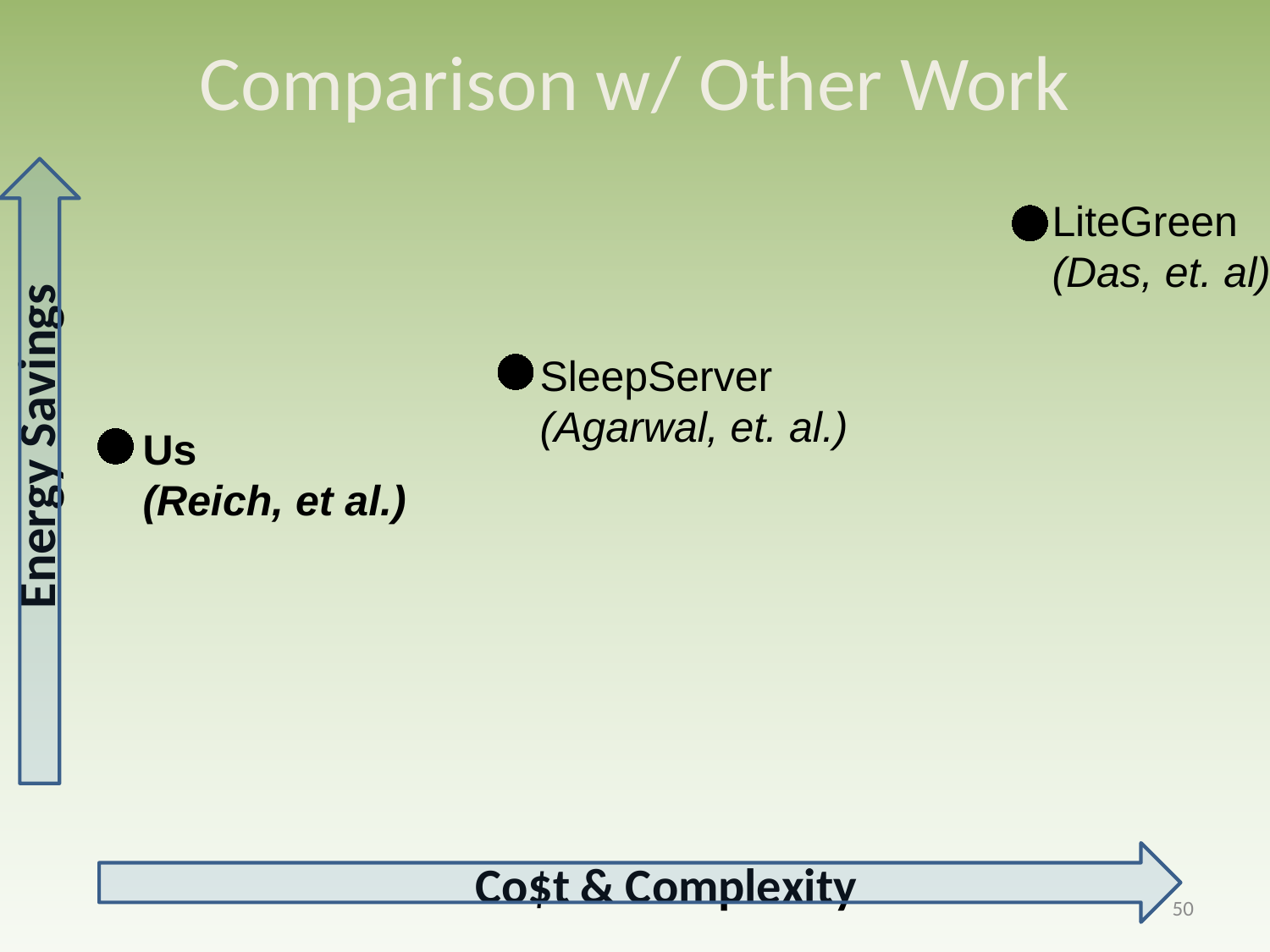
What kind of chart is shown on the slide? scatter plot What is the label of the horizontal axis? Cost & Complexity Which point is placed lowest on the Cost & Complexity axis? Us How many points are plotted on the chart? 3 Which point is placed lowest on the Energy Savings axis? Us Which is placed further along the Cost & Complexity axis, SleepServer or LiteGreen? LiteGreen What is the label of the vertical axis? Energy Savings Which is placed higher on the Energy Savings axis, SleepServer or Us? SleepServer Which authors are credited for the SleepServer point? Agarwal, et. al. Which point is placed highest on the Energy Savings axis? LiteGreen Do the points rise or fall in Energy Savings as Cost & Complexity increases along the x axis? rise Which point is placed furthest along the Cost & Complexity axis? LiteGreen